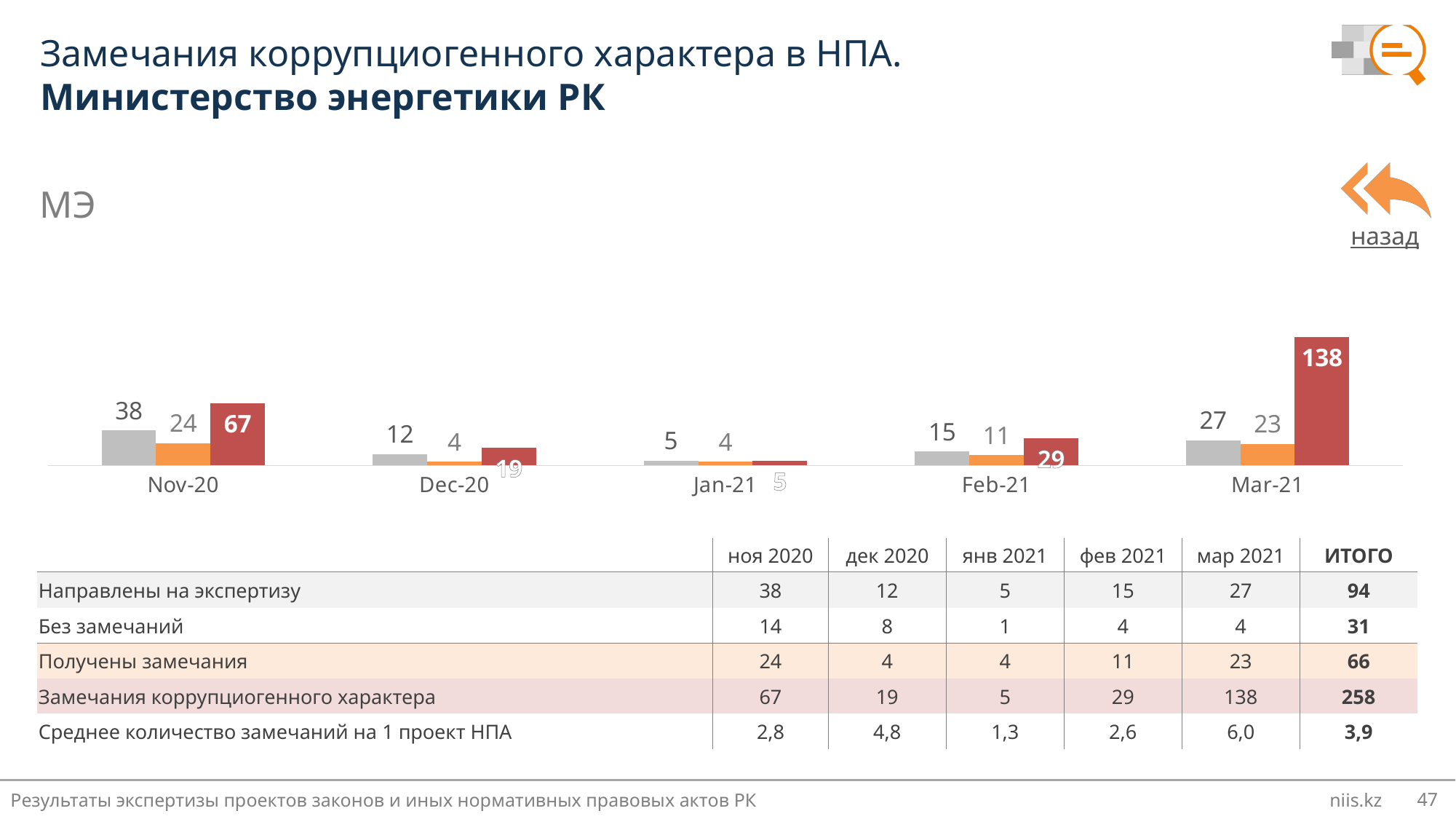
What colour are the bars representing Замечания коррупциогенного характера? red How many months (categories) are shown on the x axis of the chart? 5 What is the value of the orange bar (Получены замечания) for Feb-21? 11 Do the red bar values rise or fall from Jan-21 to Mar-21? rise What is the difference between the red bar values for Mar-21 and Nov-20? 71 What is the value of the red bar for Dec-20? 19 What is the value of the red bar (Замечания коррупциогенного характера) for Mar-21? 138 In which month is the red bar (Замечания коррупциогенного характера) the highest? Mar-21 Which is larger: the grey bar for Nov-20 or the grey bar for Mar-21? Nov-20 What is the value of the grey bar (Направлены на экспертизу) for Nov-20? 38 What type of chart is shown on the slide? bar chart In which month is the grey bar (Направлены на экспертизу) the lowest? Jan-21